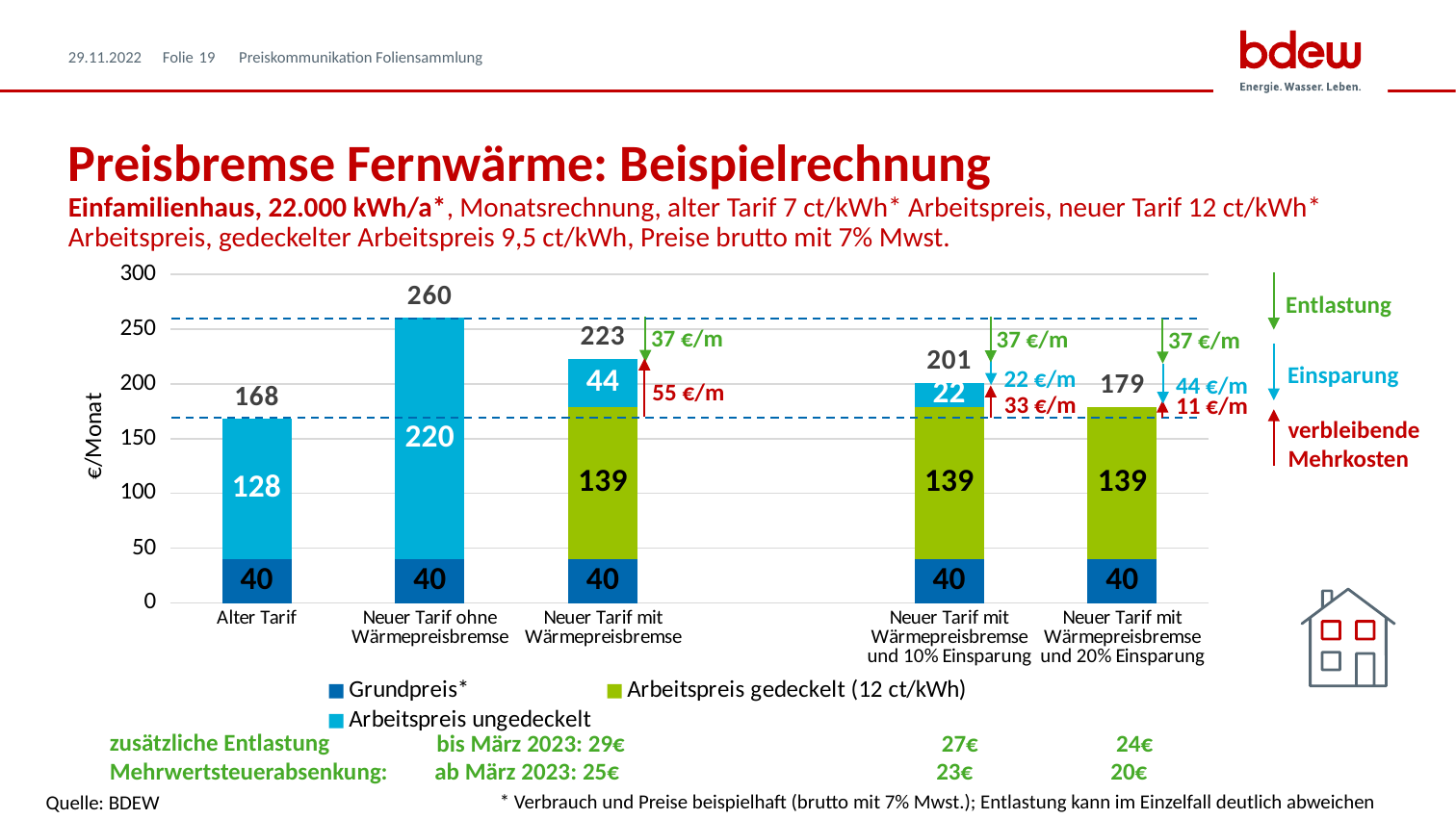
How many bars (categories) are plotted in the chart? 5 Which category has the lowest total monthly cost? Alter Tarif What is the value of 'Arbeitspreis ungedeckelt' for 'Alter Tarif'? 128 Which is larger: the total for 'Neuer Tarif mit Wärmepreisbremse' or the total for 'Neuer Tarif mit Wärmepreisbremse und 10% Einsparung'? Neuer Tarif mit Wärmepreisbremse Which category has the highest total monthly cost? Neuer Tarif ohne Wärmepreisbremse What is the difference between the total for 'Neuer Tarif ohne Wärmepreisbremse' and the total for 'Alter Tarif'? 92 What is the value of 'Grundpreis*' for 'Neuer Tarif mit Wärmepreisbremse und 20% Einsparung'? 40 What is the value of 'Arbeitspreis gedeckelt (12 ct/kWh)' for 'Neuer Tarif mit Wärmepreisbremse'? 139 What is the total monthly cost shown for 'Neuer Tarif ohne Wärmepreisbremse'? 260 What type of chart is shown on the slide? Stacked bar chart What is the label of the y axis? €/Monat How many series does the legend list? 3